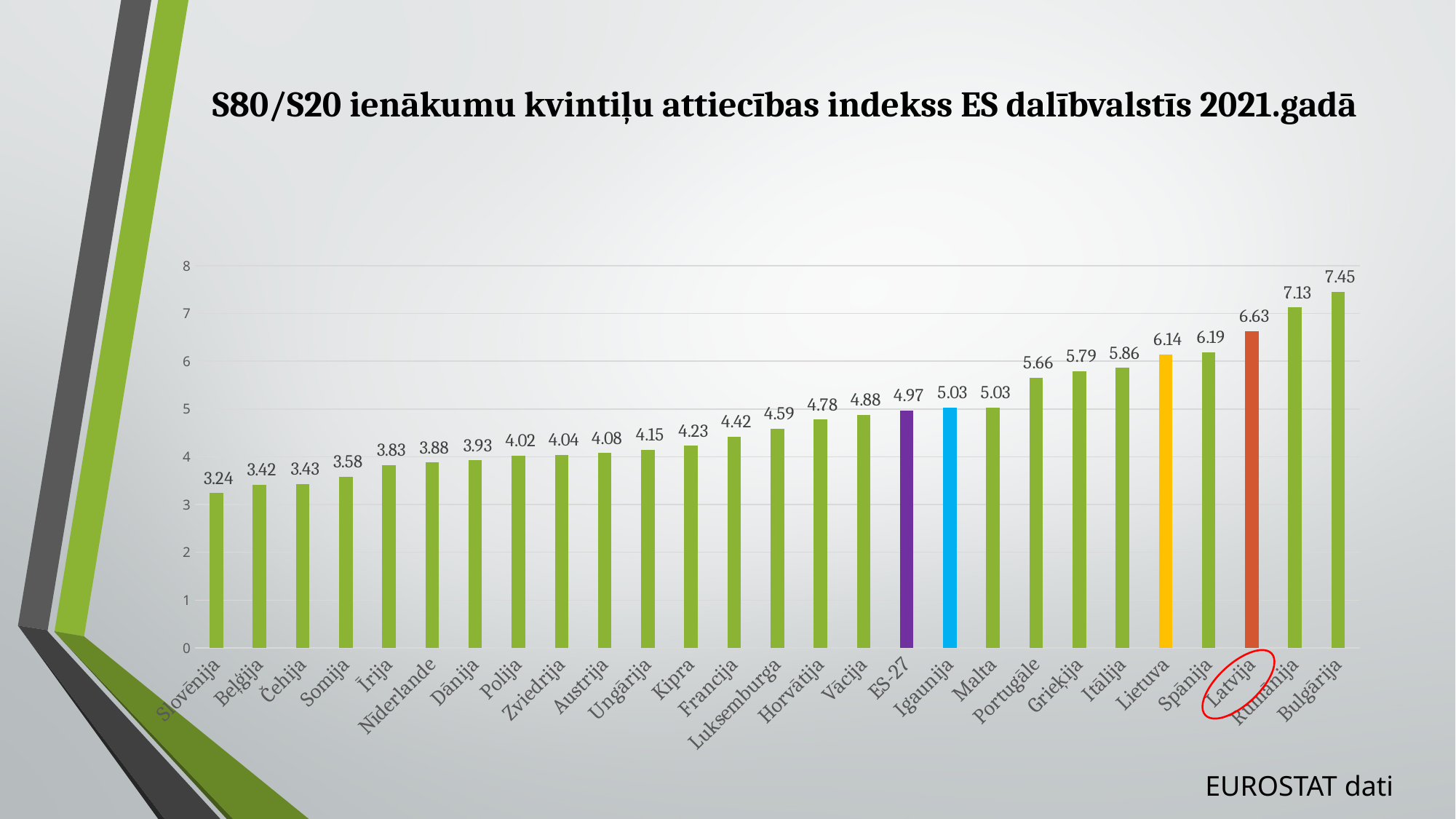
Which country has the highest value? Bulgārija What kind of chart is shown on the slide? bar chart How many bars are shown in the chart? 27 Do the values rise or fall from left to right along the x axis? rise What is the difference between the values for Latvija and ES-27? 1.66 Which is larger, the value for Igaunija or the value for Lietuva? Lietuva Which country has the lowest value? Slovēnija Is the value for Spānija greater or less than 6? greater What is the difference between the values for Bulgārija and Rumānija? 0.32 What is the value for ES-27? 4.97 What is the value for Latvija? 6.63 What is the value for Lietuva? 6.14